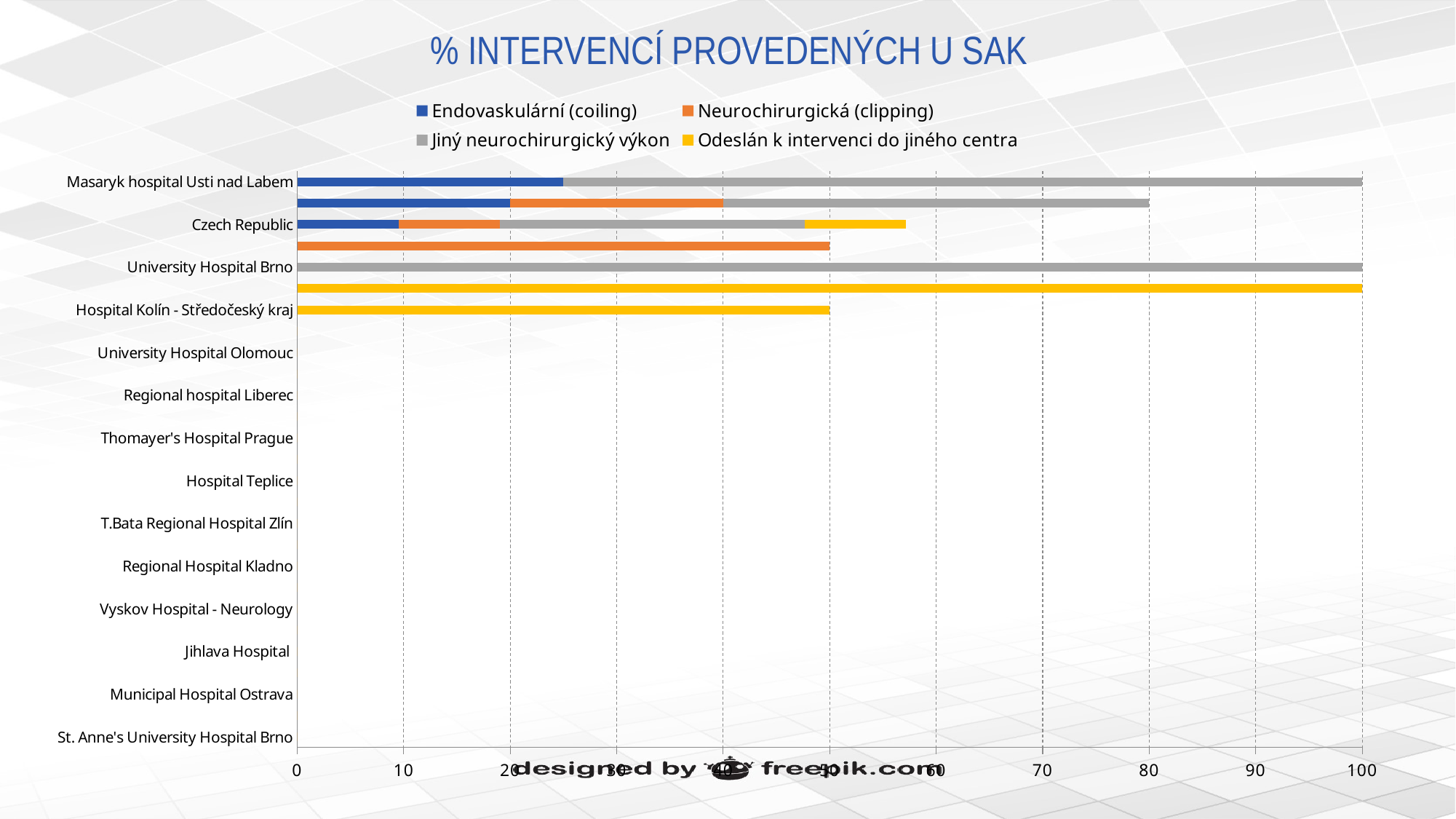
How many series does the legend list? 4 What is the Jiný neurochirurgický výkon value for University Hospital Brno? 100 Is the Endovaskulární (coiling) value for Czech Republic greater or less than 20? less Is the total bar length for Masaryk hospital Usti nad Labem greater or less than 90? greater How many hospital categories are listed on the vertical axis? 14 What kind of chart is shown on the slide? bar chart What is the maximum value shown on the horizontal axis? 100 Is the value for Hospital Kolín - Středočeský kraj greater or less than 60? less What is the title of the chart? % INTERVENCÍ PROVEDENÝCH U SAK Which colour represents the series 'Odeslán k intervenci do jiného centra' in the legend? yellow Which has the longer total bar: Masaryk hospital Usti nad Labem or Hospital Kolín - Středočeský kraj? Masaryk hospital Usti nad Labem